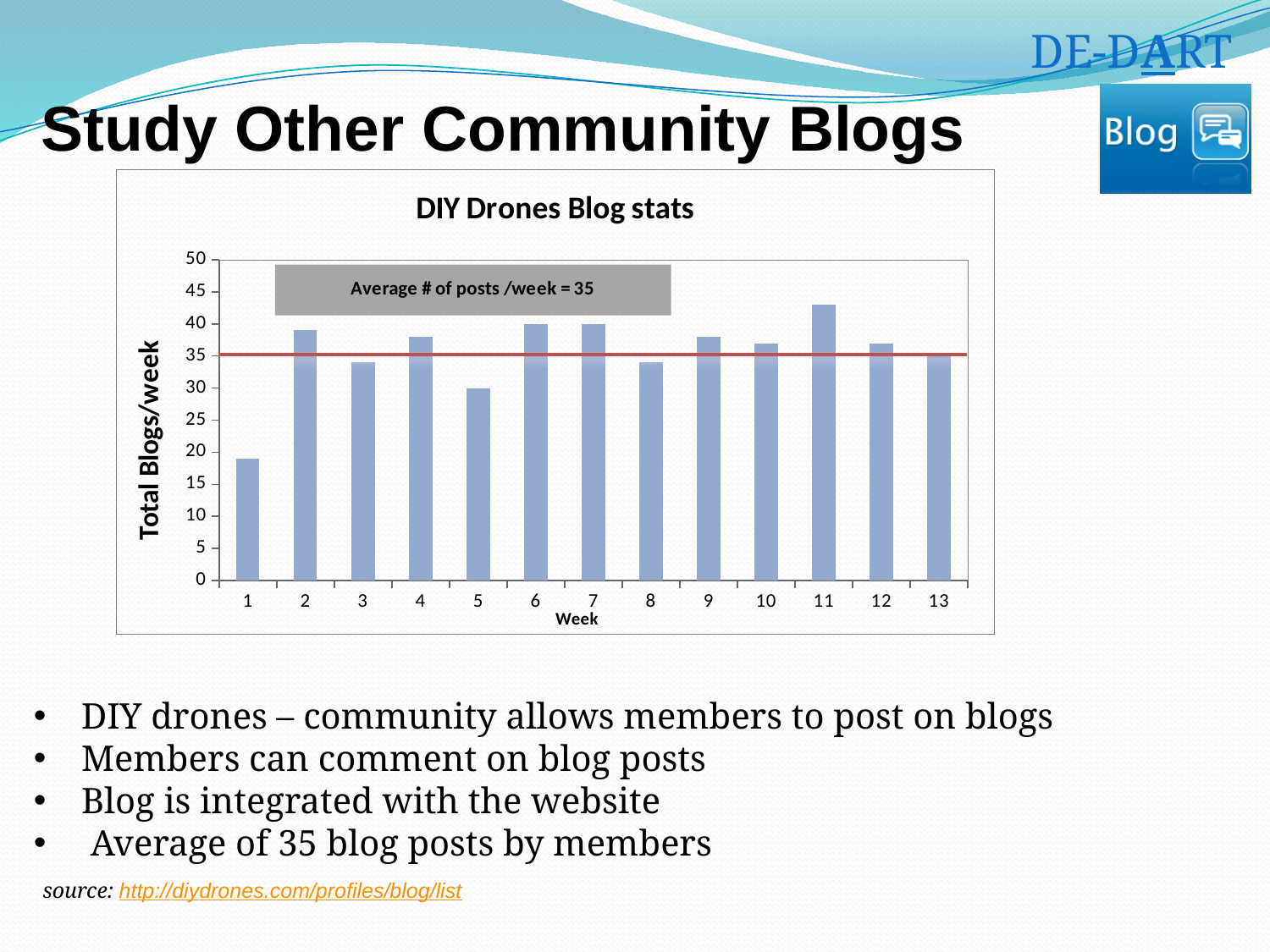
Is the value for week 11 greater or less than 40? greater Which week has the highest number of total blogs per week? 11 Is the value for week 2 greater or less than 35? greater How many weeks are plotted on the x axis of the chart? 13 Is the value for week 1 greater or less than 20? less What is the label on the y axis of the chart? Total Blogs/week What type of chart is shown on the slide? bar chart According to the label on the chart, what is the average number of posts per week? 35 Which week has the lowest number of total blogs per week? 1 Which week has more total blogs, week 1 or week 5? 5 What is the title of the chart? DIY Drones Blog stats